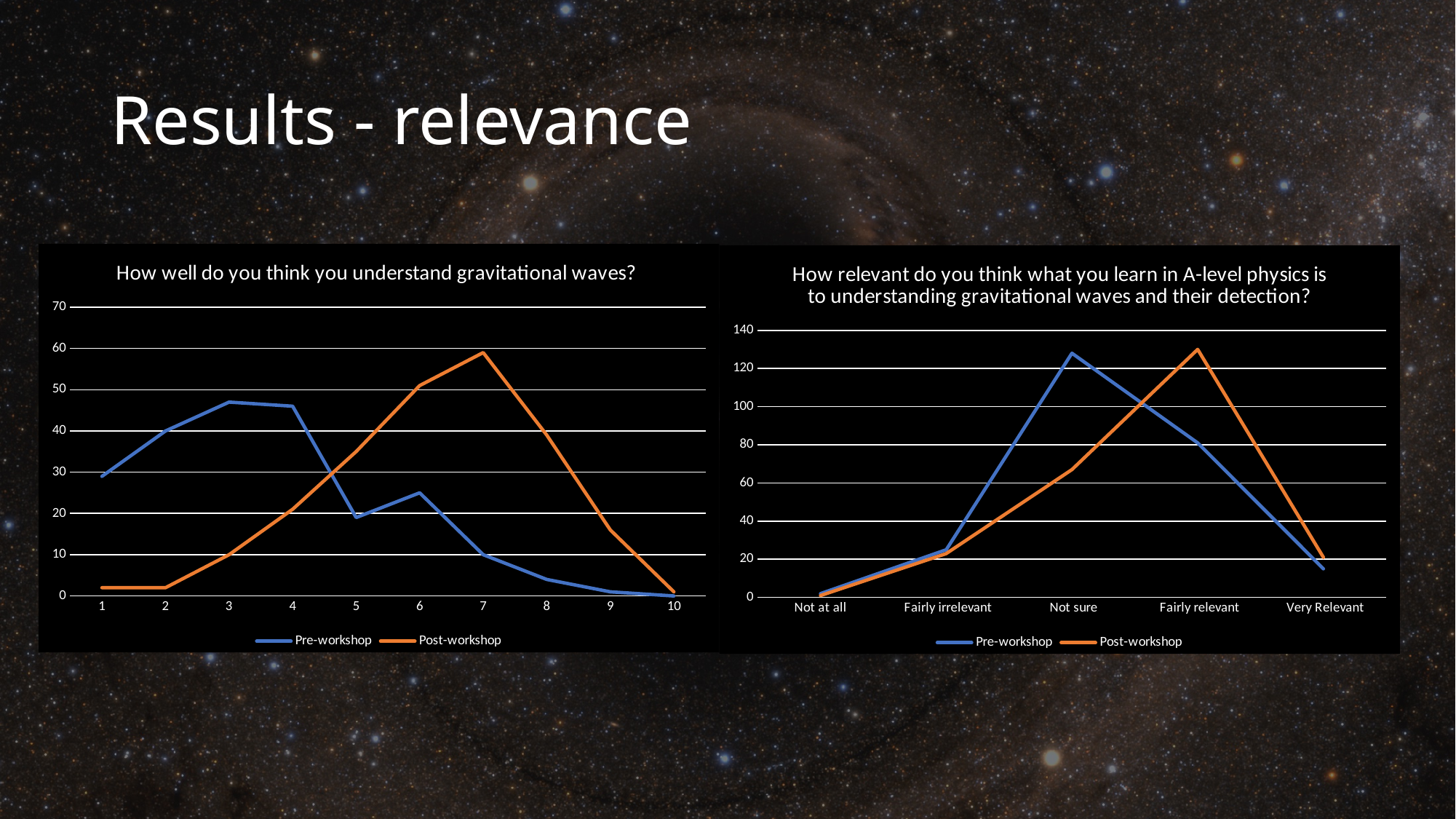
On the right chart about relevance of A-level physics, which category has the highest Pre-workshop value? Not sure On the left chart, 'How well do you think you understand gravitational waves?', at which x value does the Post-workshop series reach its highest point? 7 What kind of chart is the left chart, 'How well do you think you understand gravitational waves?' line chart How many categories are on the x axis of the right chart about relevance of A-level physics? 5 On the right chart about relevance of A-level physics, which category has the highest Post-workshop value? Fairly relevant On the left chart, 'How well do you think you understand gravitational waves?', is the Post-workshop value at 7 greater or less than 50? greater How many series does the legend list on the right chart, 'How relevant do you think what you learn in A-level physics is to understanding gravitational waves and their detection?' 2 On the right chart about relevance of A-level physics, which series is larger at Fairly relevant, Pre-workshop or Post-workshop? Post-workshop How many points are on the x axis of the left chart, 'How well do you think you understand gravitational waves?' 10 On the right chart about relevance of A-level physics, is the Pre-workshop value for Not sure greater or less than 120? greater On the left chart, 'How well do you think you understand gravitational waves?', which series is larger at 3, Pre-workshop or Post-workshop? Pre-workshop